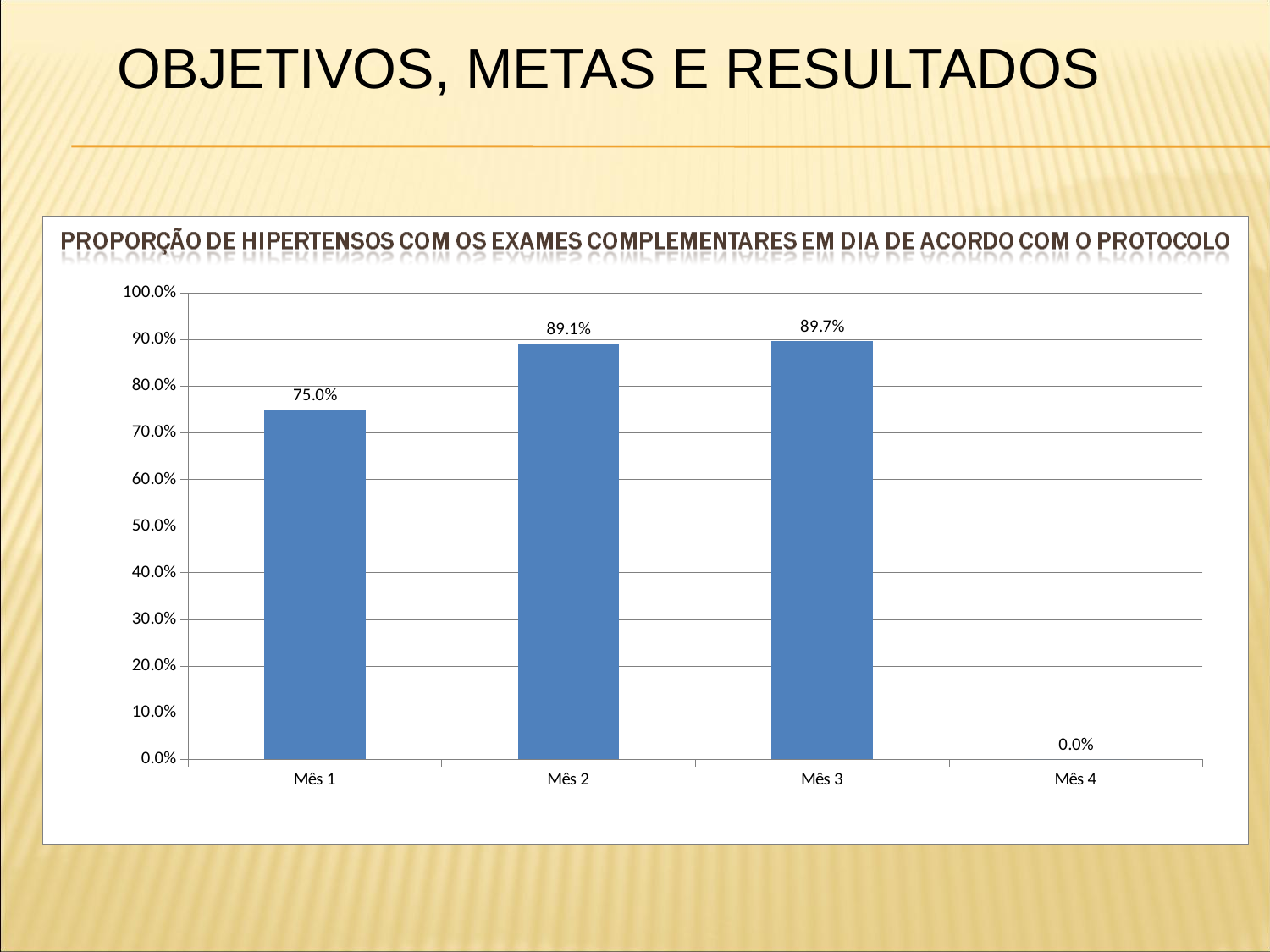
What kind of chart is shown on the slide? bar chart What is the value for Mês 2? 89.1% What is the title of the chart? Proporção de hipertensos com os exames complementares em dia de acordo com o protocolo Which is larger, the value for Mês 1 or the value for Mês 2? Mês 2 Is the value for Mês 1 greater or less than 80.0%? less Which category has the lowest value? Mês 4 What is the value for Mês 4? 0.0% What is the difference between the values for Mês 2 and Mês 1? 14.1% What is the value for Mês 3? 89.7% What is the difference between the values for Mês 3 and Mês 2? 0.6% What is the value for Mês 1? 75.0% How many categories are shown on the x axis? 4